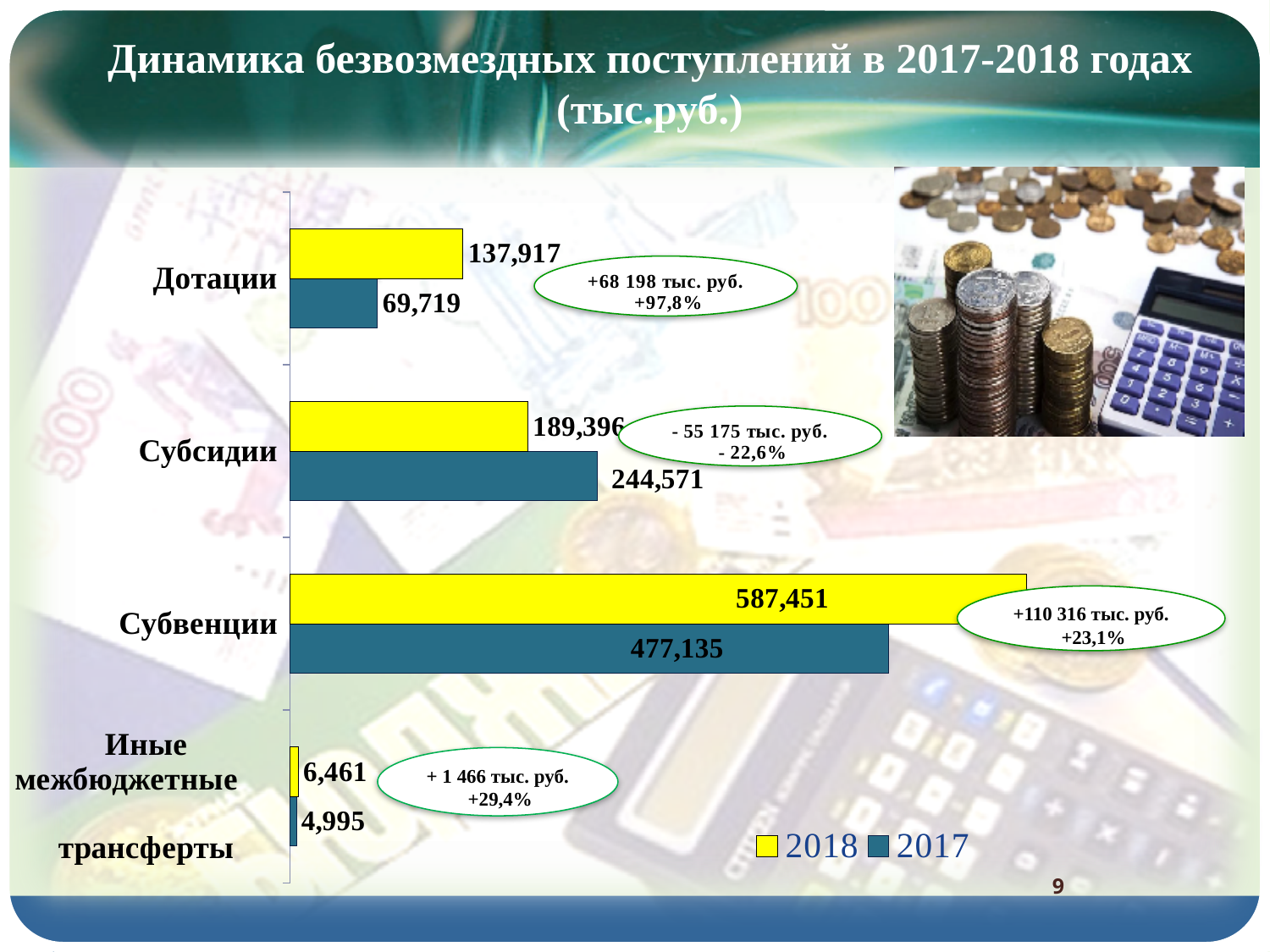
What is the difference between the 2018 and 2017 values for Дотации? 68,198 What is the value for Субсидии in 2017? 244,571 What is the value for Субвенции in 2018? 587,451 What is the difference between the 2017 and 2018 values for Субсидии? 55,175 How many categories are shown in the chart? 4 What is the value for Дотации in 2018? 137,917 Which category has the lowest value in 2017? Иные межбюджетные трансферты Which is larger for Субсидии, the 2018 value or the 2017 value? 2017 How many series does the legend list? 2 Which category has the highest value in 2018? Субвенции What kind of chart is shown on the slide? Bar chart What is the value for Иные межбюджетные трансферты in 2017? 4,995